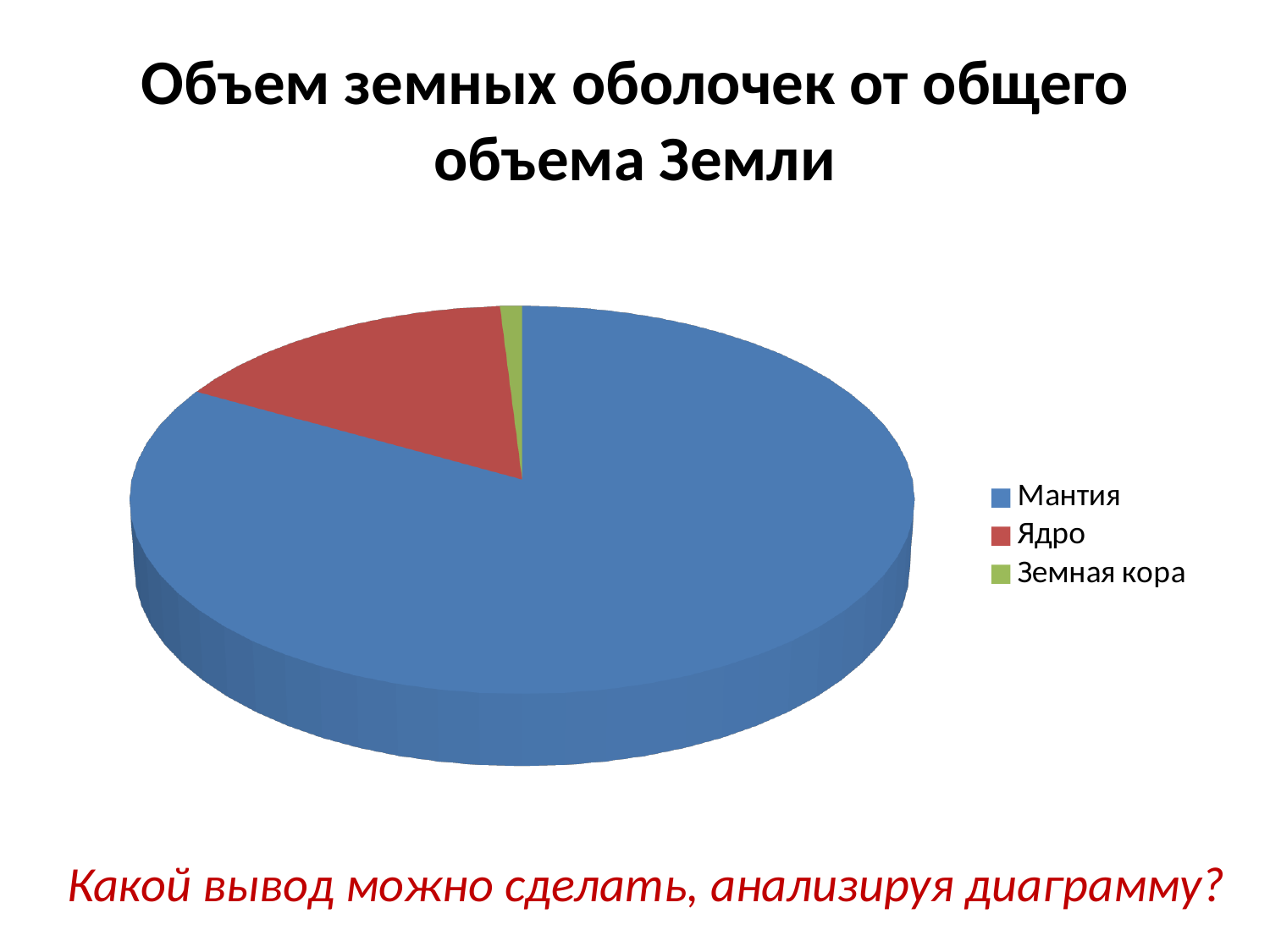
What kind of chart is shown on the slide? pie chart What is the title of the chart on the slide? Объем земных оболочек от общего объема Земли Which category has the largest slice of the pie? Мантия How many entries does the legend list? 3 Which category has the smallest slice of the pie? Земная кора How many slices does the pie chart have? 3 Which slice is larger, Ядро or Земная кора? Ядро Which slice is larger, Мантия or Ядро? Мантия What colour is the slice for Ядро? red